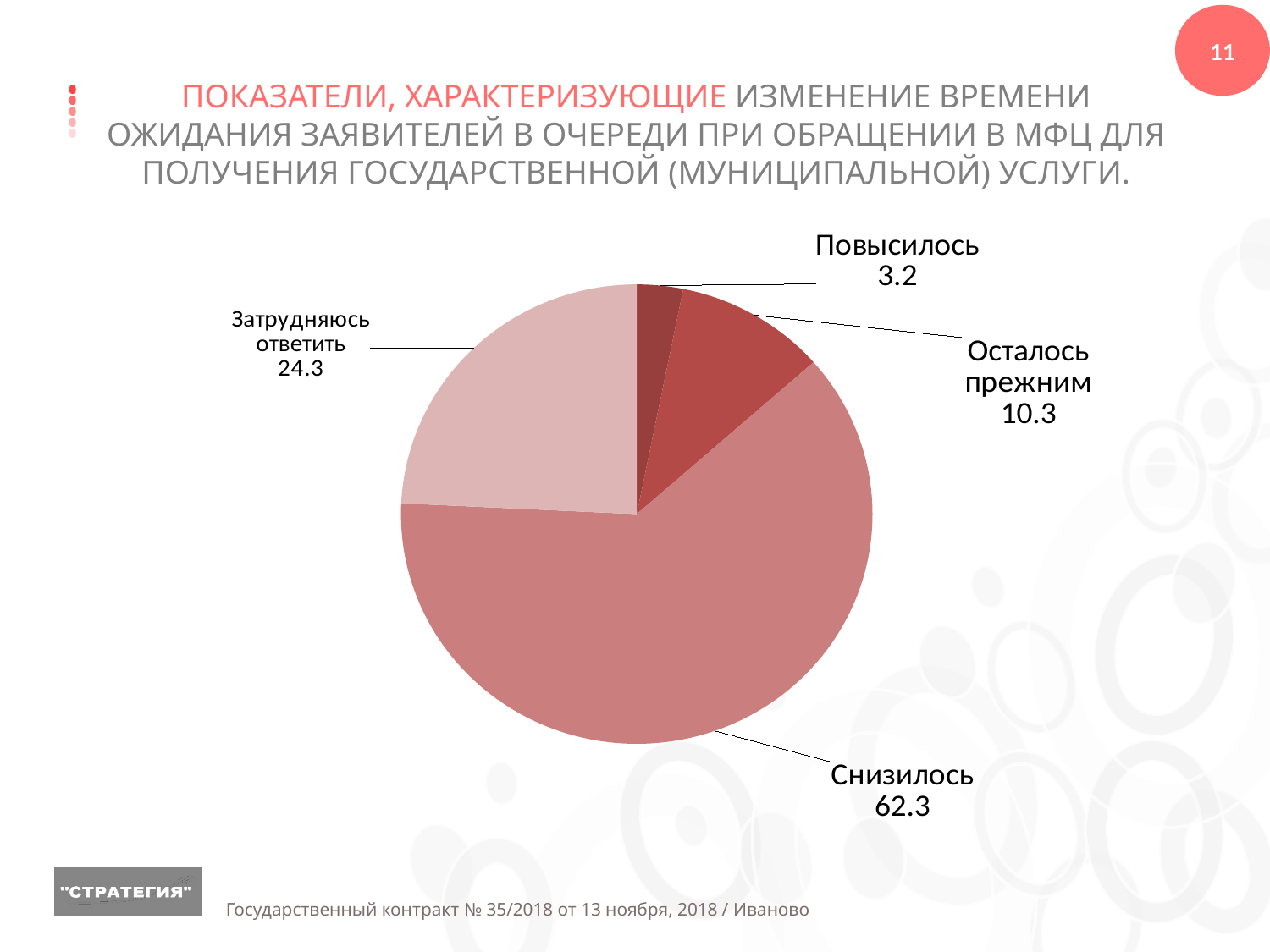
What is the value for the slice labelled "Снизилось"? 62.3 What is the value for the slice labelled "Осталось прежним"? 10.3 What kind of chart is shown on the slide? pie chart Which slice of the pie chart is the smallest? Повысилось What is the value for the slice labelled "Затрудняюсь ответить"? 24.3 Which slice of the pie chart is the largest? Снизилось What is the value for the slice labelled "Повысилось"? 3.2 Which is larger, the value for "Затрудняюсь ответить" or the value for "Осталось прежним"? Затрудняюсь ответить Which slice of the pie chart is the lightest in colour? Затрудняюсь ответить What is the difference between the values for "Снизилось" and "Затрудняюсь ответить"? 38.0 How many slices does the pie chart have? 4 What is the difference between the values for "Осталось прежним" and "Повысилось"? 7.1